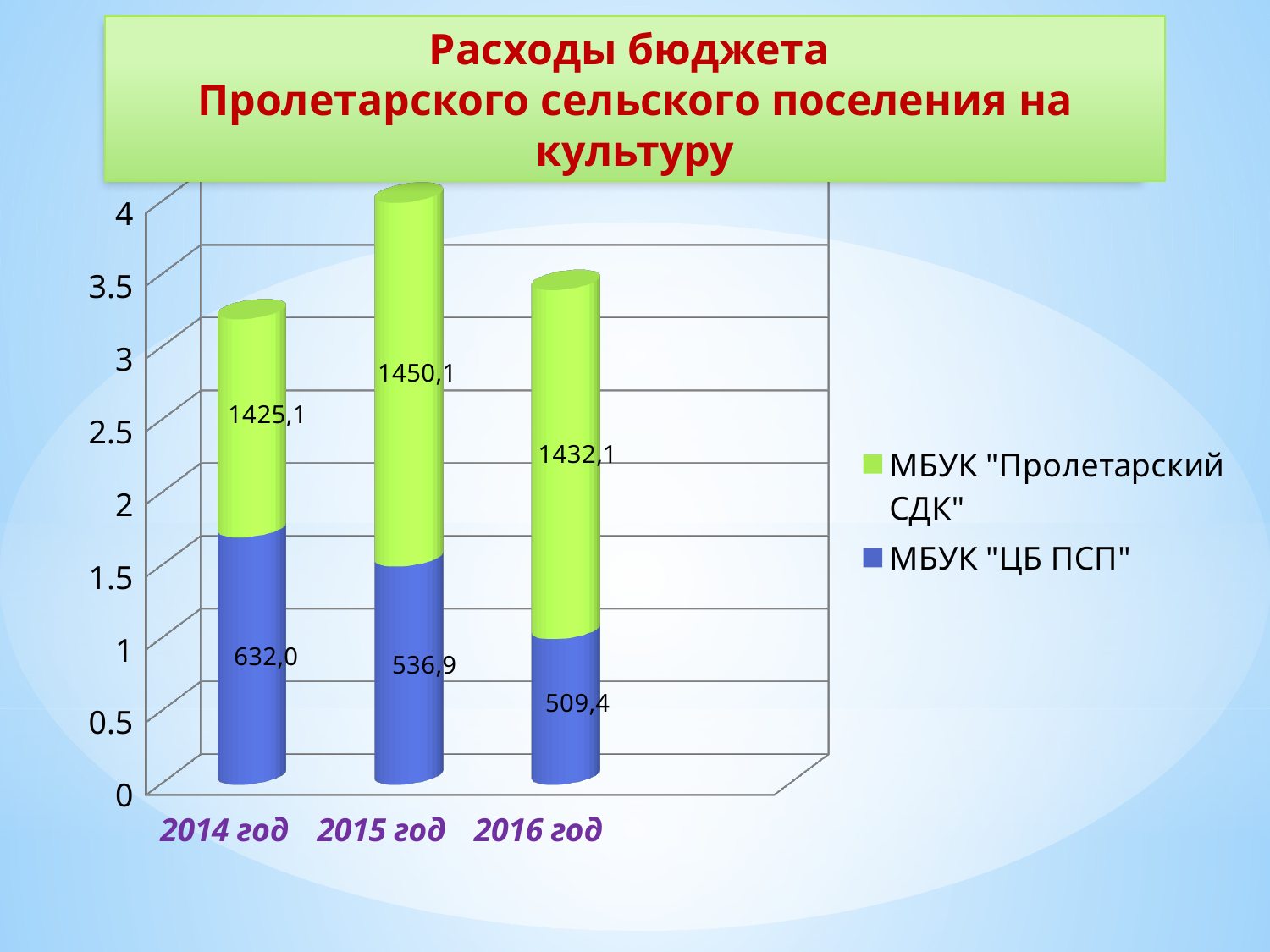
What is the total of the stacked bar for 2014 год? 2057,1 What is the value for МБУК "ЦБ ПСП" in 2015 год? 536,9 What kind of chart is shown on the slide? Stacked bar chart Which is larger: the МБУК "Пролетарский СДК" value in 2016 год or in 2014 год? 2016 год How many years are shown on the x axis? 3 How many series does the legend list? 2 In which year is the value for МБУК "Пролетарский СДК" the highest? 2015 год What is the value for МБУК "Пролетарский СДК" in 2014 год? 1425,1 In which year is the value for МБУК "ЦБ ПСП" the lowest? 2016 год What is the difference between the МБУК "ЦБ ПСП" values for 2014 год and 2016 год? 122,6 Do the values for МБУК "ЦБ ПСП" rise or fall from 2014 год to 2016 год? Fall What is the value for МБУК "ЦБ ПСП" in 2016 год? 509,4